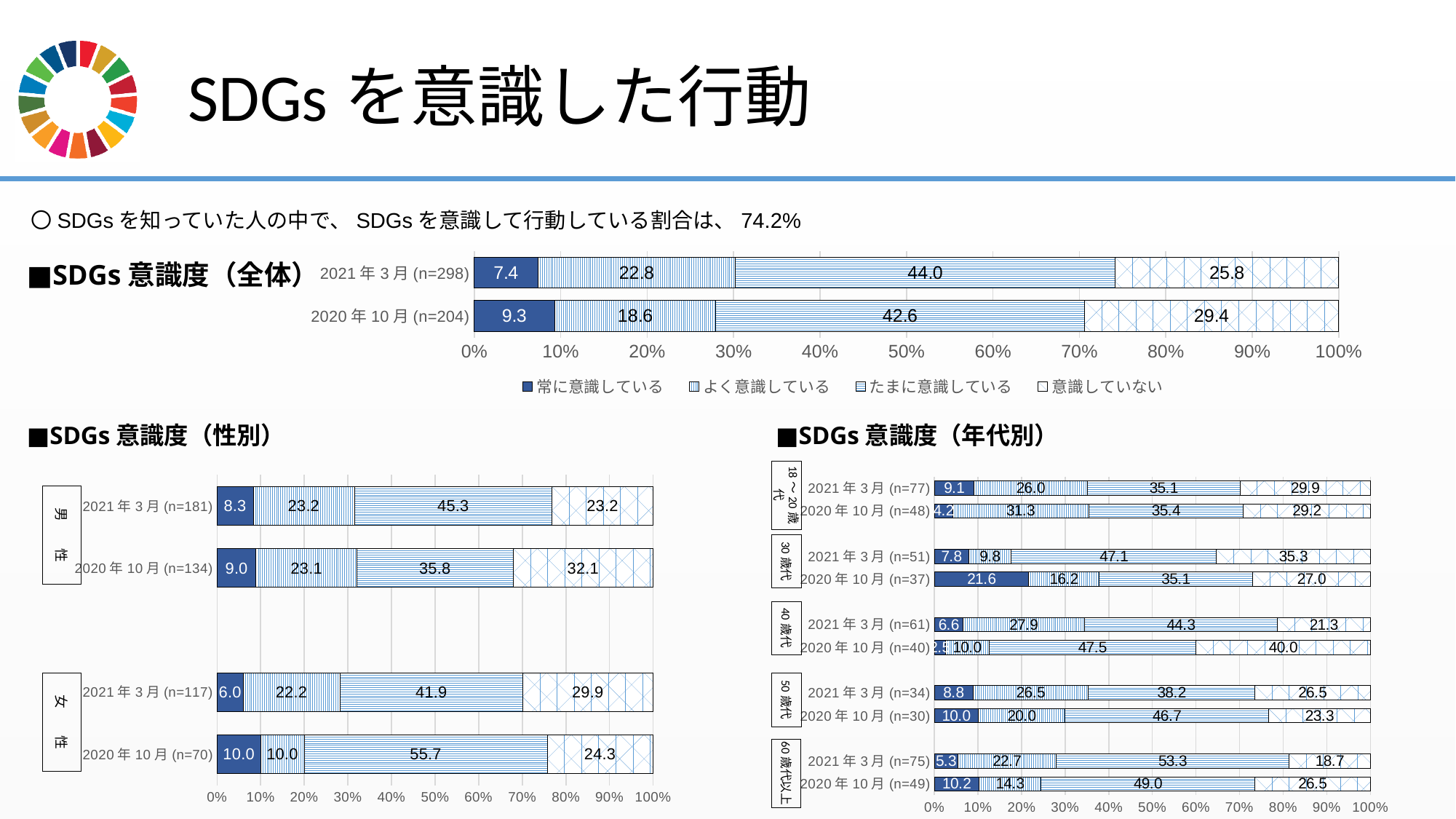
In the ■SDGs 意識度（性別） chart, what is the value for 意識していない for 男性 2020年10月 (n=134)? 32.1 In the ■SDGs 意識度（全体） chart, what is the value for 意識していない in 2020年10月 (n=204)? 29.4 What kind of chart is the ■SDGs 意識度（全体） chart? Stacked bar chart In the ■SDGs 意識度（全体） chart, how many bars are plotted? 2 In the ■SDGs 意識度（全体） chart, what is the difference between the たまに意識している values for 2021年3月 and 2020年10月? 1.4 In the ■SDGs 意識度（性別） chart, which has the larger たまに意識している value in 2021年3月: 男性 or 女性? 男性 In the ■SDGs 意識度（全体） chart, what is the value for 常に意識している in 2021年3月 (n=298)? 7.4 In the ■SDGs 意識度（年代別） chart, what is the value for 常に意識している for 30歳代 2020年10月 (n=37)? 21.6 In the ■SDGs 意識度（性別） chart, what is the value for たまに意識している for 女性 2020年10月 (n=70)? 55.7 In the ■SDGs 意識度（年代別） chart, what is the value for たまに意識している for 60歳代以上 2021年3月 (n=75)? 53.3 In the ■SDGs 意識度（全体） chart, how many series does the legend list? 4 In the ■SDGs 意識度（年代別） chart, which bar has the highest 常に意識している value? 30歳代 2020年10月 (n=37)